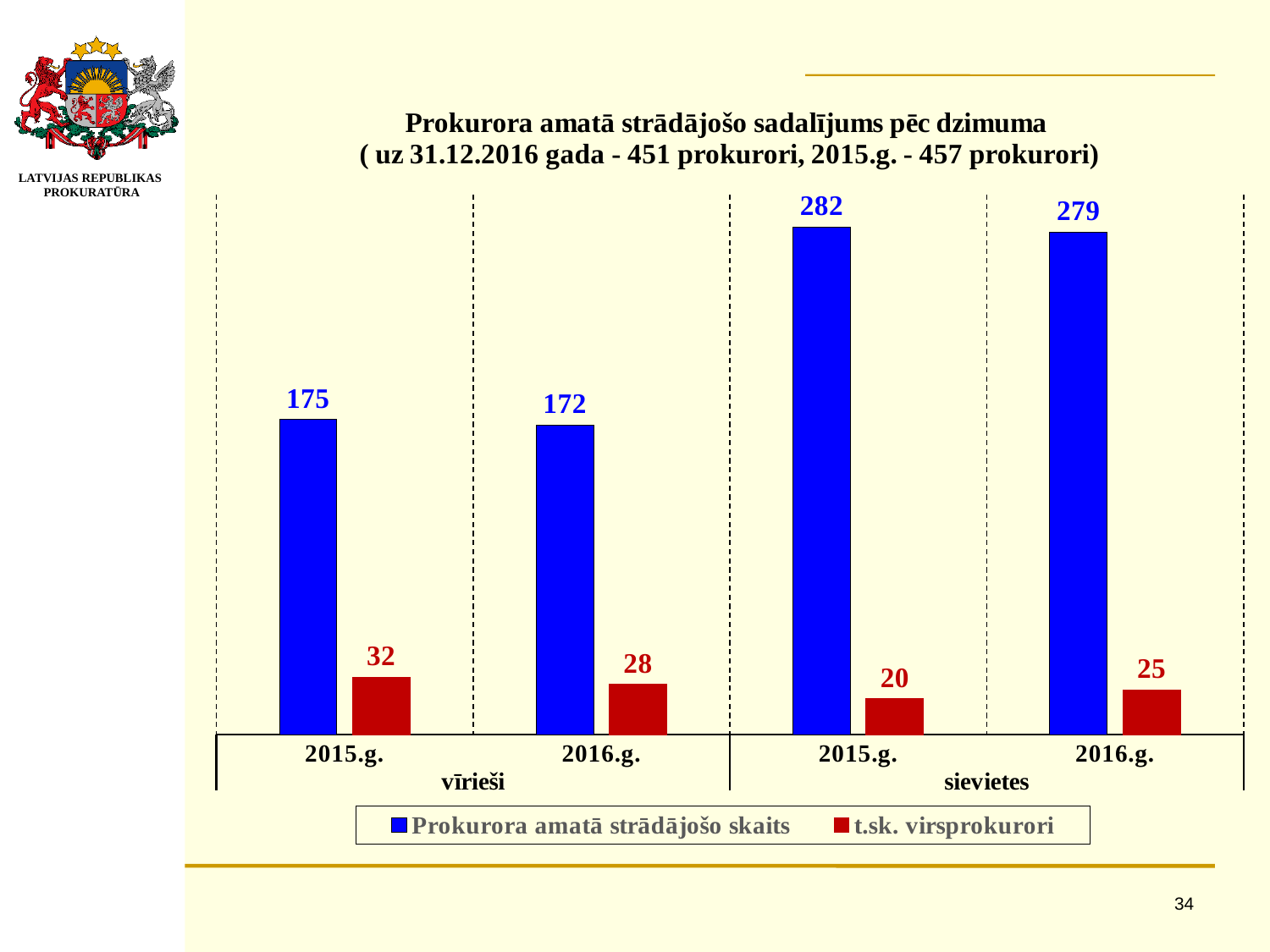
Which category has the lowest value for 't.sk. virsprokurori'? sievietes 2015.g. Which is larger: 't.sk. virsprokurori' for vīrieši in 2016.g. or for sievietes in 2016.g.? vīrieši 2016.g. Which category has the highest value for 'Prokurora amatā strādājošo skaits'? sievietes 2015.g. What is the value of 'Prokurora amatā strādājošo skaits' for sievietes in 2015.g.? 282 What is the value of 't.sk. virsprokurori' for sievietes in 2016.g.? 25 What colour are the bars for 't.sk. virsprokurori'? red What kind of chart is shown on the slide? bar chart What is the difference between 't.sk. virsprokurori' for vīrieši in 2015.g. and 2016.g.? 4 What is the difference between 'Prokurora amatā strādājošo skaits' for sievietes in 2016.g. and vīrieši in 2016.g.? 107 How many categories are shown on the x axis? 4 What is the value of 'Prokurora amatā strādājošo skaits' for vīrieši in 2015.g.? 175 How many series does the legend list? 2